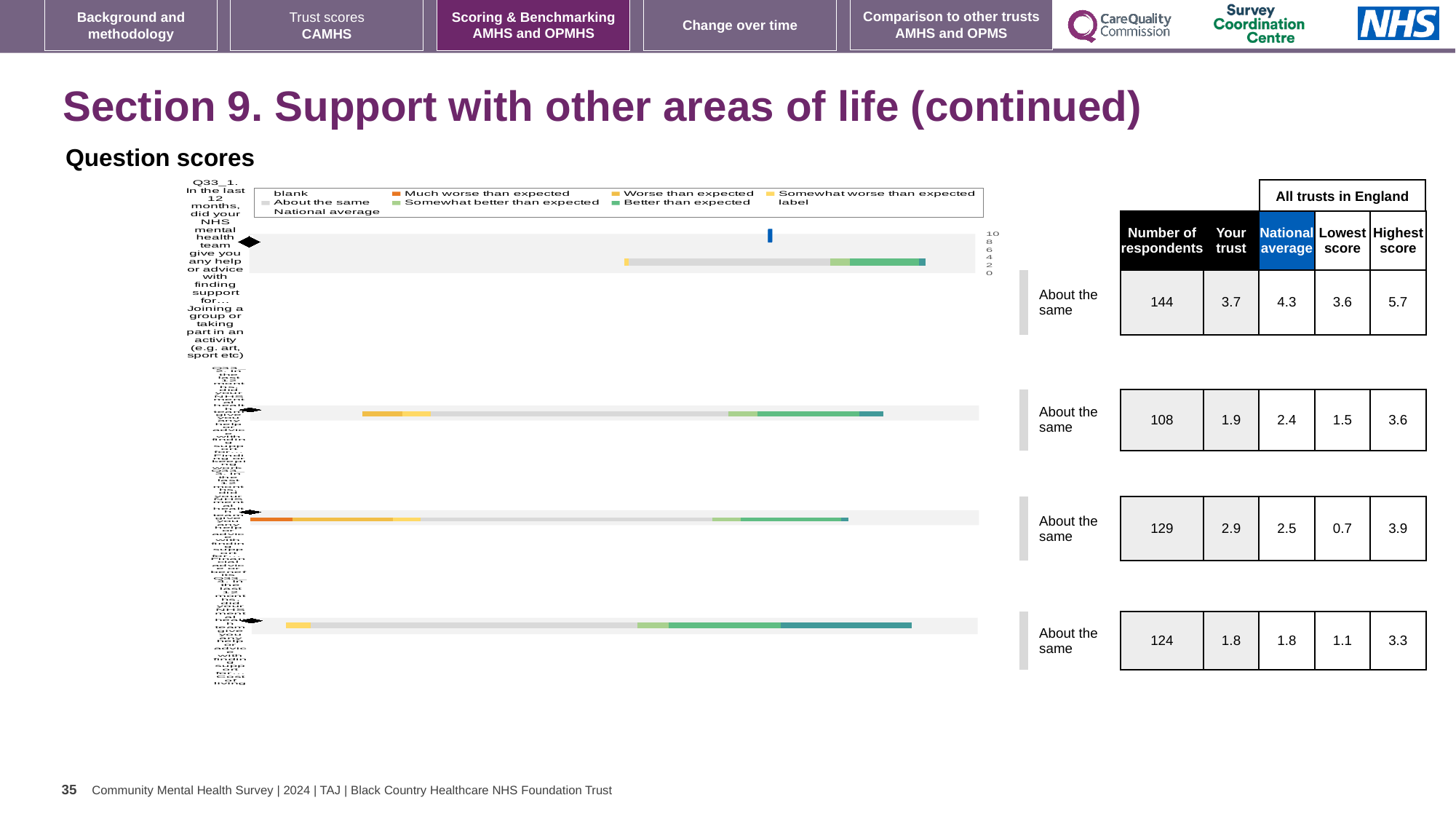
What is the highest value shown on the chart's numeric axis? 10 How many entries does the chart's legend list? 9 For the first question (Q33_1), which is larger: the 'Your trust' score or the national average? National average What comparison label is shown next to each of the four bars in the chart? About the same In the table beside the chart, what is the difference between the highest score and the lowest score for the first question (Q33_1)? 2.1 In the table beside the chart, what is the number of respondents for the first question (Q33_1, joining a group or taking part in an activity)? 144 What colour does the legend use for 'Much worse than expected'? orange In the table beside the chart, what is the national average for the first question (Q33_1)? 4.3 In the table beside the chart, what is the 'Your trust' score for the first question (Q33_1)? 3.7 In the table beside the chart, which row has the highest number of respondents? the first row (Q33_1), 144 How many horizontal bars (questions) are plotted in the chart? 4 What kind of chart is shown under 'Question scores'? bar chart